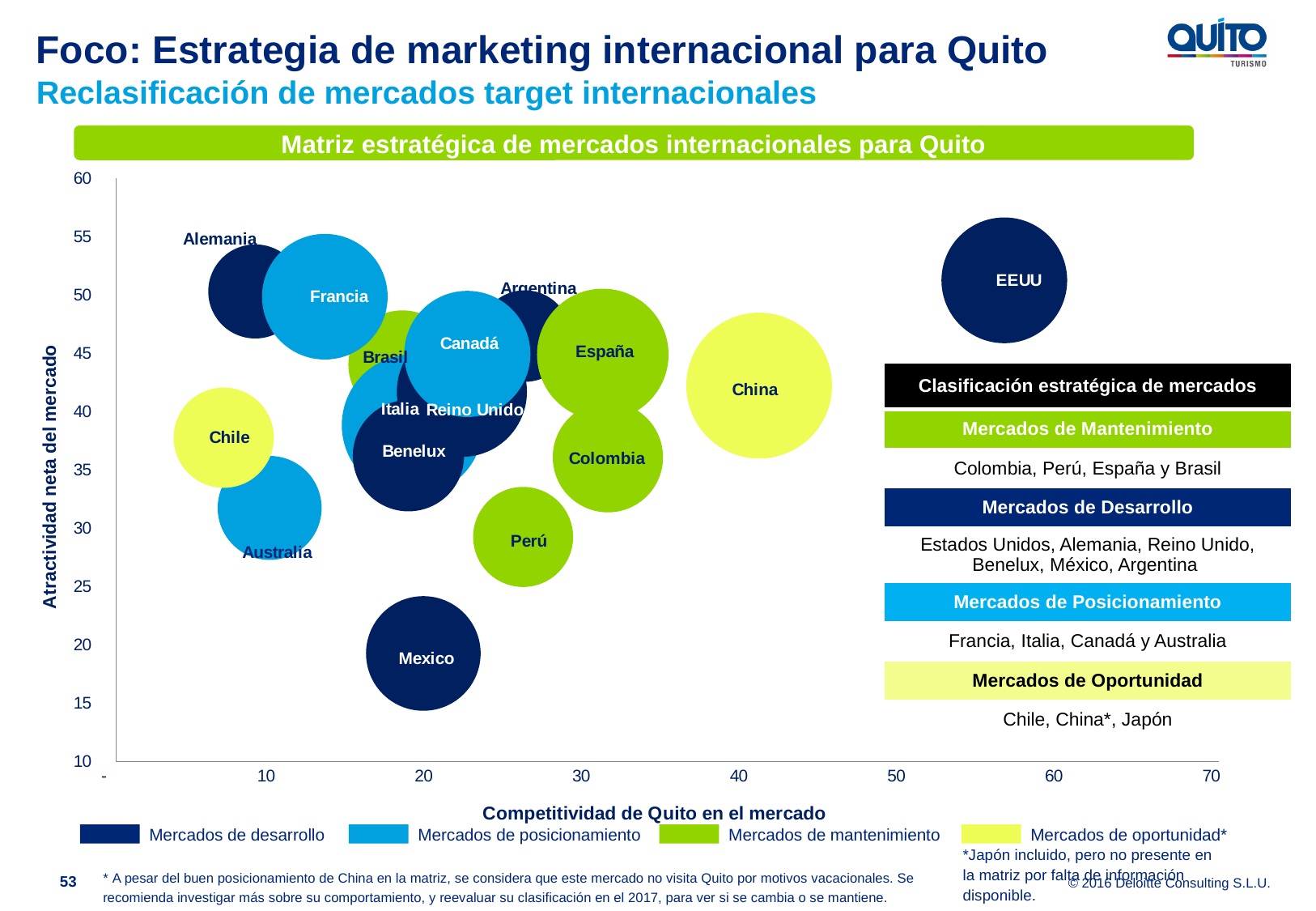
What kind of chart is shown on the slide? Bubble chart Is the Atractividad neta del mercado value for Perú greater or less than 35? less Which legend series does the China bubble belong to? Mercados de oportunidad* Which market has the highest value on the Competitividad de Quito en el mercado axis? EEUU Is the Competitividad de Quito en el mercado value for EEUU greater or less than 50? greater What is the title of the chart? Matriz estratégica de mercados internacionales para Quito Which has a higher Atractividad neta del mercado value, Alemania or Mexico? Alemania Is the Competitividad de Quito en el mercado value for China greater or less than 30? greater Which market has the lowest value on the Atractividad neta del mercado axis? Mexico How many market bubbles are plotted on the chart? 16 How many series does the chart legend list? 4